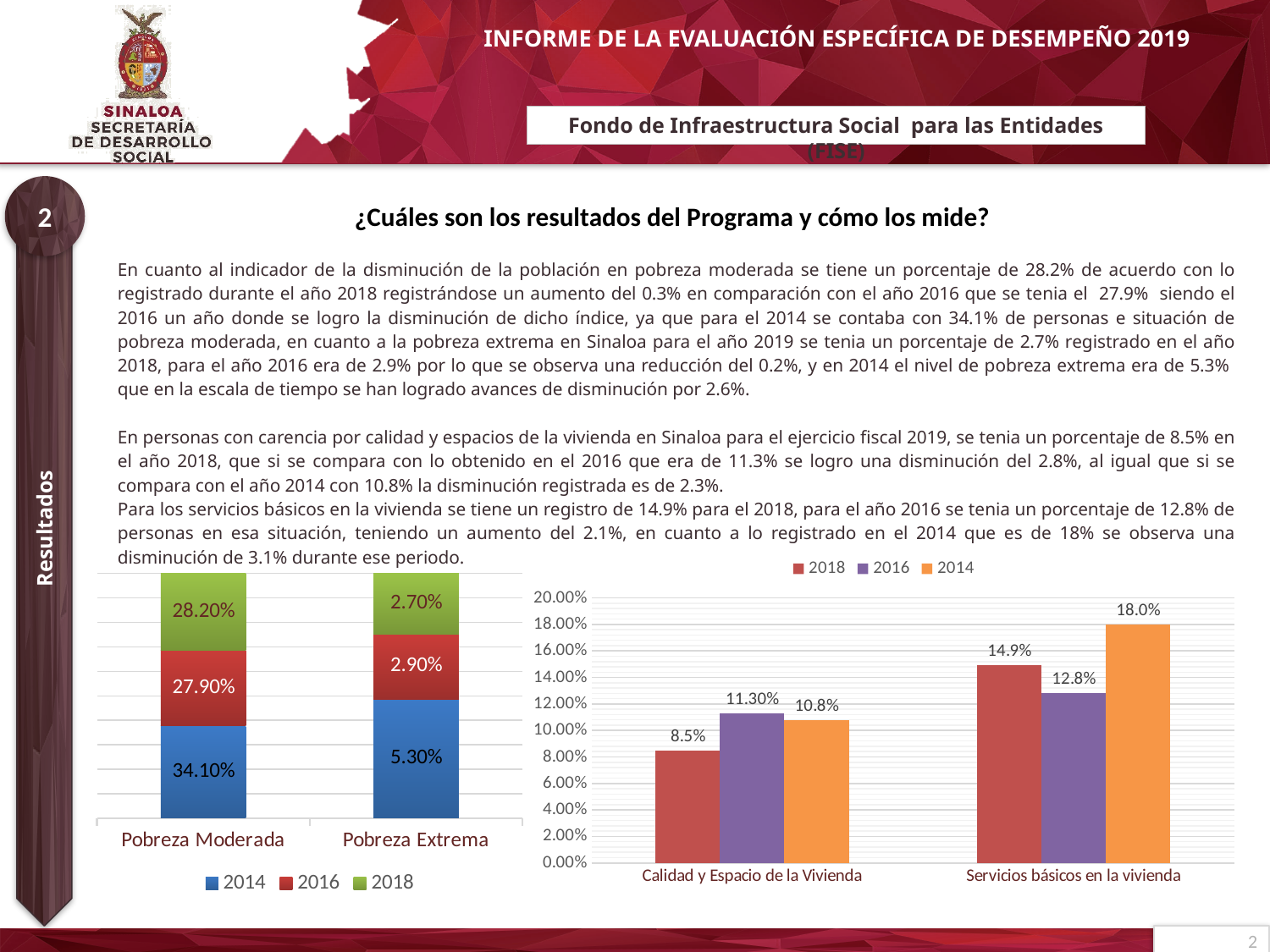
In the right chart, what is the 2016 value for Calidad y Espacio de la Vivienda? 11.30% What kind of chart is the chart on the right of the slide? bar chart In the left stacked bar chart, what is the difference between the 2014 and 2016 values for Pobreza Moderada? 6.20% In the right chart, what is the difference between the 2014 and 2018 values for Servicios básicos en la vivienda? 3.1% In the right chart, what is the 2014 value for Servicios básicos en la vivienda? 18.0% In the right chart, which series has the highest value for Servicios básicos en la vivienda? 2014 In the left stacked bar chart, what is the total of the stacked bar for Pobreza Extrema? 10.90% In the right chart, which series has the lowest value for Calidad y Espacio de la Vivienda? 2018 In the left stacked bar chart, what is the 2018 value for Pobreza Extrema? 2.70% In the left stacked bar chart, what is the 2014 value for Pobreza Moderada? 34.10% In the right chart, is the 2018 value for Calidad y Espacio de la Vivienda larger or smaller than the 2018 value for Servicios básicos en la vivienda? smaller How many series does the legend of the left stacked bar chart list? 3